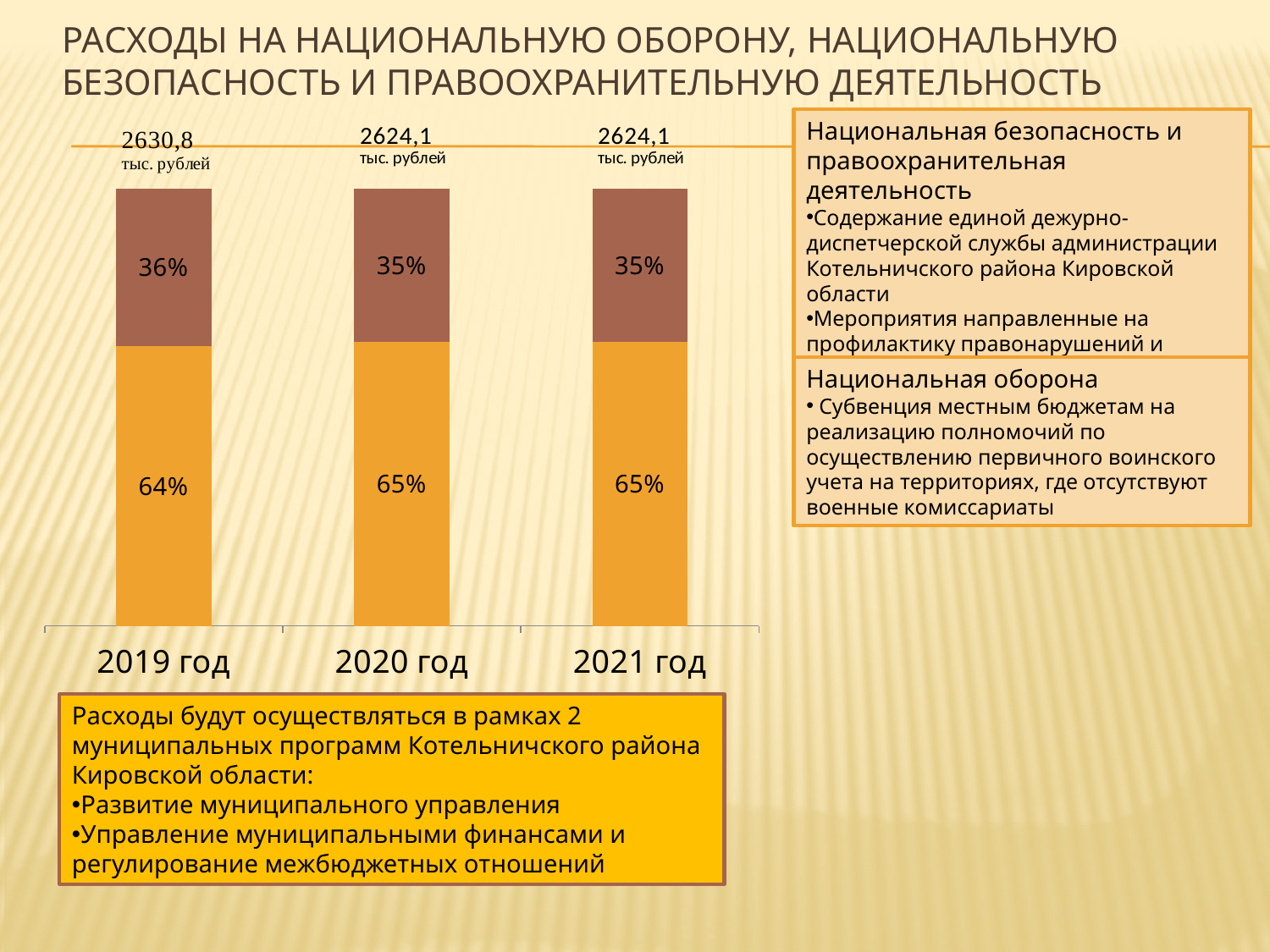
Does the share of the upper brown segment rise or fall from 2019 год to 2020 год? fall Is the lower orange segment larger in 2019 год or in 2020 год? 2020 год By how much does the amount printed above the 2019 год bar exceed the amount above the 2020 год bar? 6,7 тыс. рублей Which year has the highest total amount printed above its bar? 2019 год How many segments does each stacked bar consist of? 2 What percentage is printed on the lower orange segment of the 2019 год bar? 64% What kind of chart is shown on the slide? stacked bar chart What total amount is printed above the 2021 год bar? 2624,1 тыс. рублей How many years (categories) are shown on the x axis of the chart? 3 What percentage is printed on the upper brown segment of the 2020 год bar? 35% What total amount is printed above the 2019 год bar? 2630,8 тыс. рублей In the 2019 год bar, how many percentage points larger is the orange segment than the brown segment? 28 percentage points